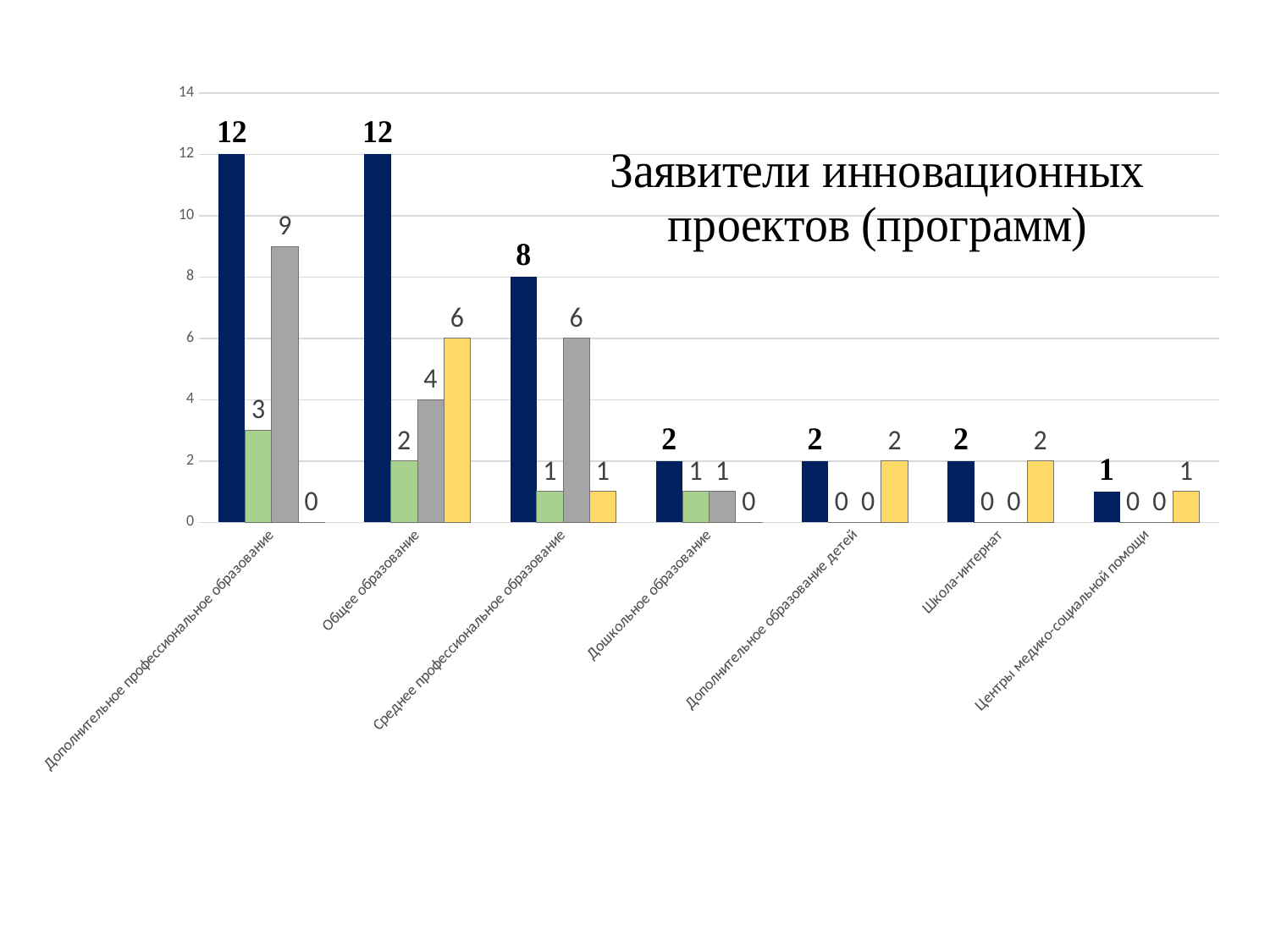
What is the value of the yellow bar for Среднее профессиональное образование? 1 What type of chart is shown on the slide? bar chart Which category has the highest grey bar? Дополнительное профессиональное образование What is the value of the green bar for Дошкольное образование? 1 What is the value of the grey bar for Дополнительное профессиональное образование? 9 How many categories are shown on the x axis of the chart? 7 What is the total of the four bars for Общее образование? 24 What is the difference between the dark blue bar and the grey bar for Среднее профессиональное образование? 2 What is the title of the chart? Заявители инновационных проектов (программ) Which category has the lowest dark blue bar? Центры медико-социальной помощи Which is larger for Общее образование: the grey bar or the yellow bar? the yellow bar What is the value of the dark blue bar for Общее образование? 12